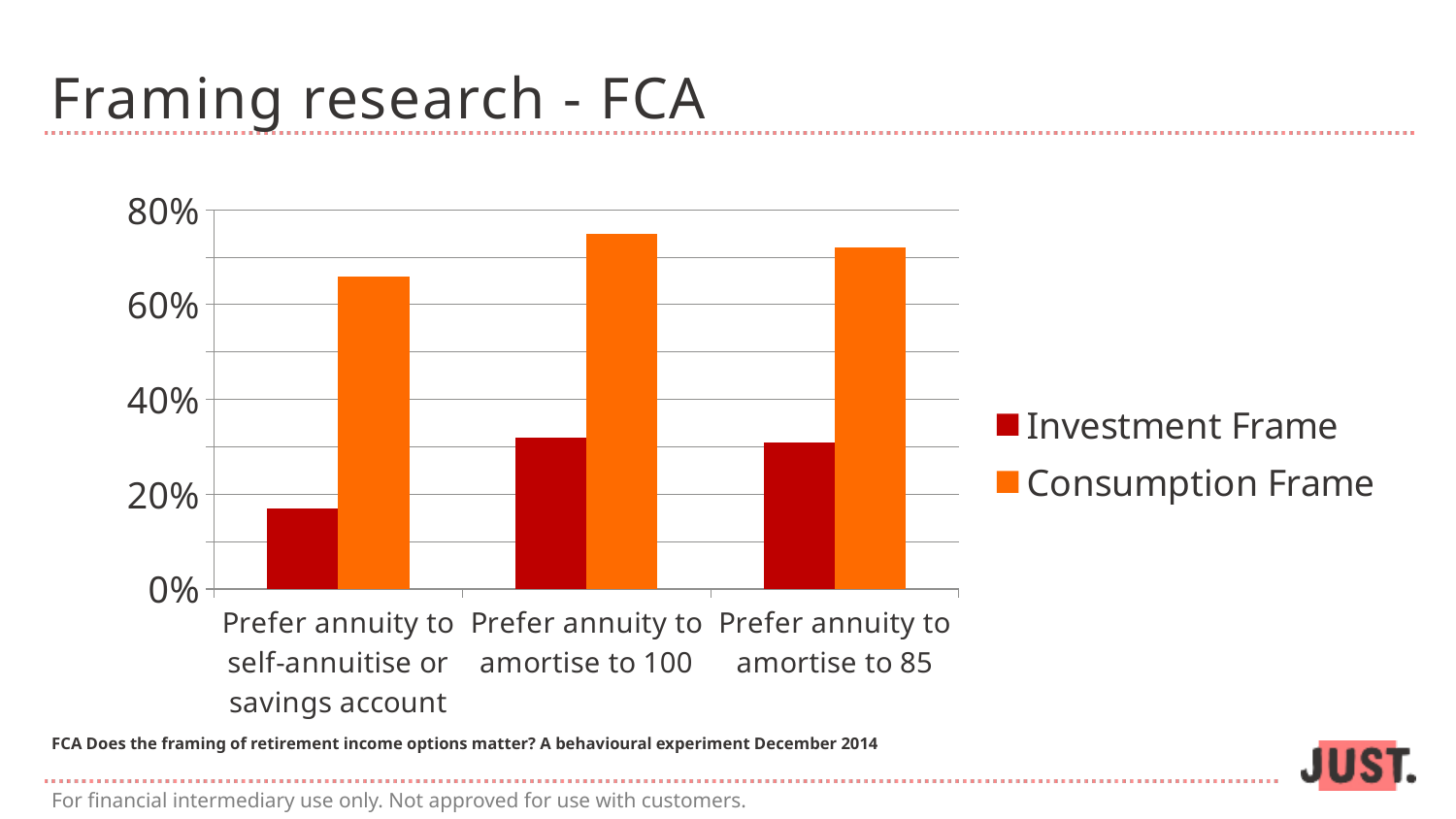
Is the Investment Frame value for 'Prefer annuity to amortise to 100' greater or less than 40%? less How many series does the legend list? 2 Which two series are listed in the legend? Investment Frame and Consumption Frame What kind of chart is shown on the slide? Bar chart Which category has the lowest Consumption Frame value? Prefer annuity to self-annuitise or savings account For 'Prefer annuity to amortise to 100', which series has the larger value, Investment Frame or Consumption Frame? Consumption Frame What is the title of the slide containing the chart? Framing research - FCA How many categories are shown on the x axis? 3 Which category has the lowest Investment Frame value? Prefer annuity to self-annuitise or savings account Is the Investment Frame value for 'Prefer annuity to self-annuitise or savings account' greater or less than 20%? less Is the Consumption Frame value for 'Prefer annuity to amortise to 85' greater or less than 60%? greater